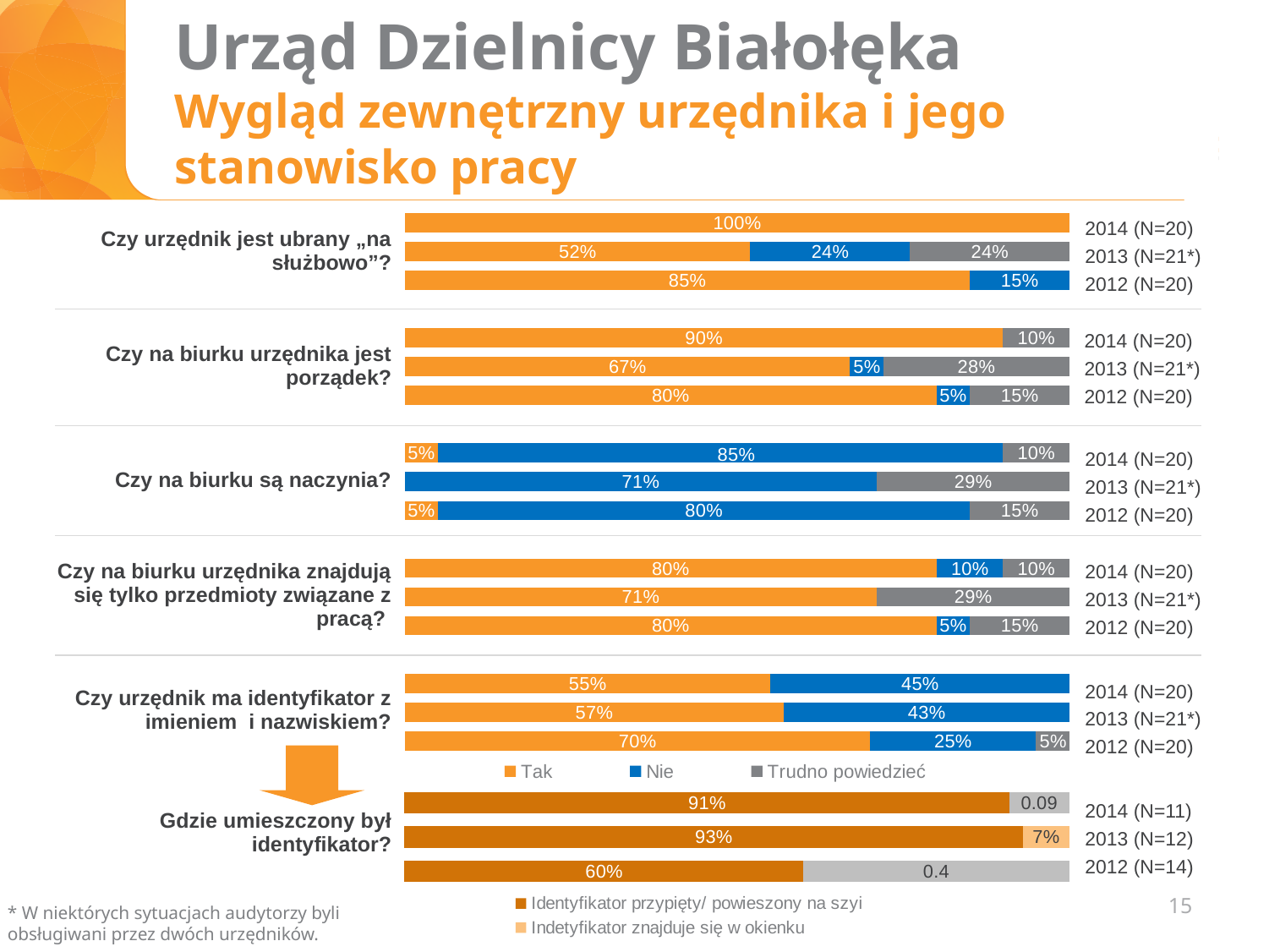
In the chart "Czy urzędnik ma identyfikator z imieniem i nazwiskiem?", what is the "Nie" value for 2013 (N=21*)? 43% In the chart "Czy na biurku urzędnika znajdują się tylko przedmioty związane z pracą?", what is the "Tak" value for 2013 (N=21*)? 71% In the chart "Czy na biurku urzędnika jest porządek?", which year has the highest "Tak" value? 2014 (N=20) In the chart "Czy urzędnik jest ubrany „na służbowo”?", what is the "Tak" value for 2014 (N=20)? 100% In the chart "Czy na biurku są naczynia?", what is the "Nie" value for 2014 (N=20)? 85% In the chart "Czy urzędnik jest ubrany „na służbowo”?", what is the "Nie" value for 2013 (N=21*)? 24% In the chart "Gdzie umieszczony był identyfikator?", what is the value for "Identyfikator przypięty/ powieszony na szyi" in 2013 (N=12)? 93% In the chart "Czy na biurku są naczynia?", what is the difference between the "Nie" values for 2014 (N=20) and 2013 (N=21*)? 14% What type of chart is used for "Czy na biurku są naczynia?"? Stacked bar chart In the chart "Czy urzędnik ma identyfikator z imieniem i nazwiskiem?", which is larger: the "Tak" value for 2014 (N=20) or for 2012 (N=20)? 2012 (N=20) In the chart "Czy na biurku urzędnika jest porządek?", what is the "Trudno powiedzieć" value for 2013 (N=21*)? 28% How many series does the legend list for the chart "Gdzie umieszczony był identyfikator?"? 2